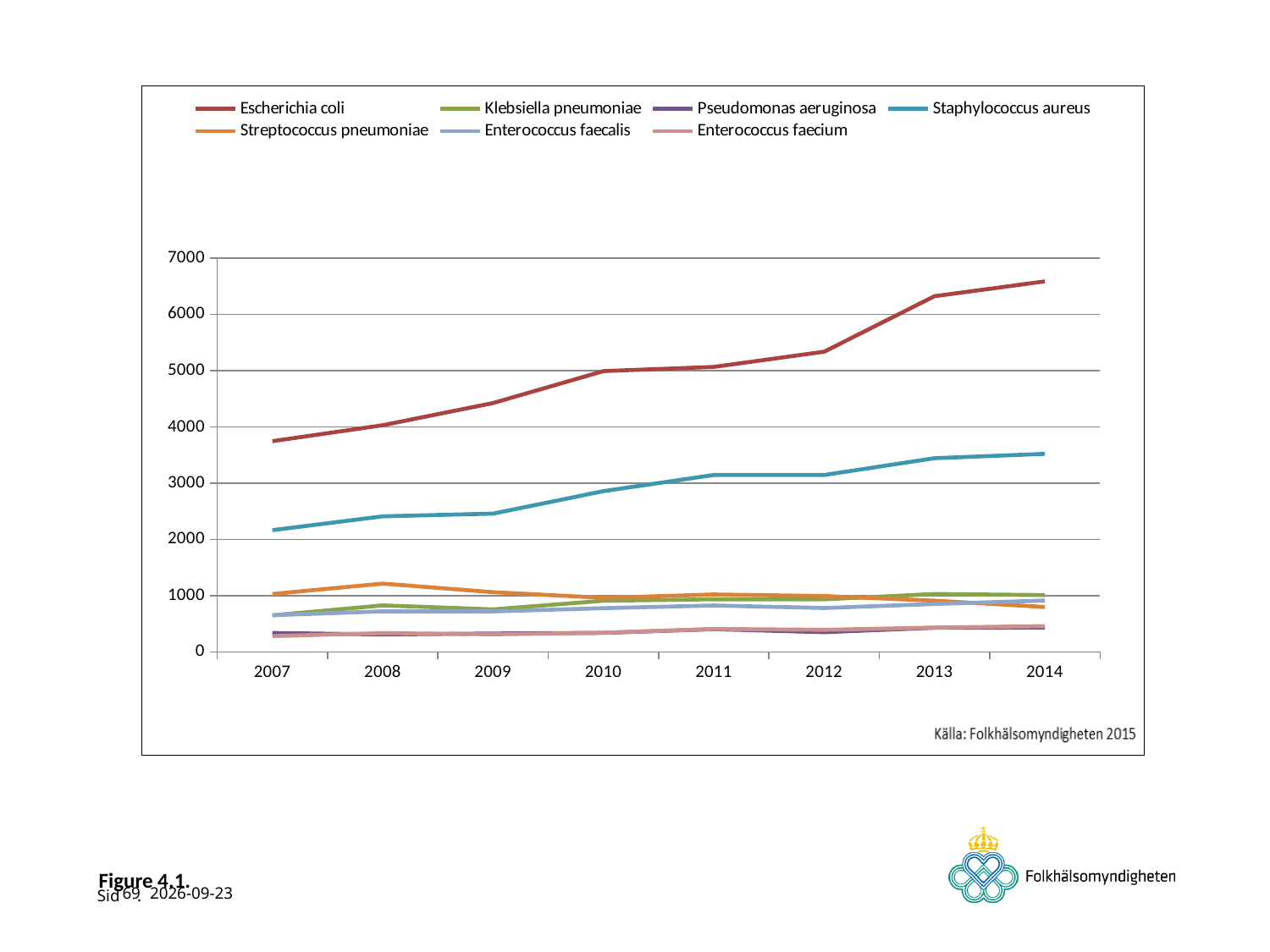
Is the value for Escherichia coli in 2007 greater or less than 4000? less Is the value for Staphylococcus aureus in 2010 greater or less than 2000? greater How many years are shown along the x axis? 8 Does the Staphylococcus aureus line rise or fall from 2007 to 2014? rises Is the value for Staphylococcus aureus in 2014 greater or less than 4000? less How many series does the legend list? 7 Does the Escherichia coli line rise or fall from 2007 to 2014? rises Which series has the highest values across all years? Escherichia coli In 2010, which is larger: the value for Escherichia coli or the value for Staphylococcus aureus? Escherichia coli What kind of chart is shown on the slide? line chart What source is cited in the bottom right corner of the chart? Källa: Folkhälsomyndigheten 2015